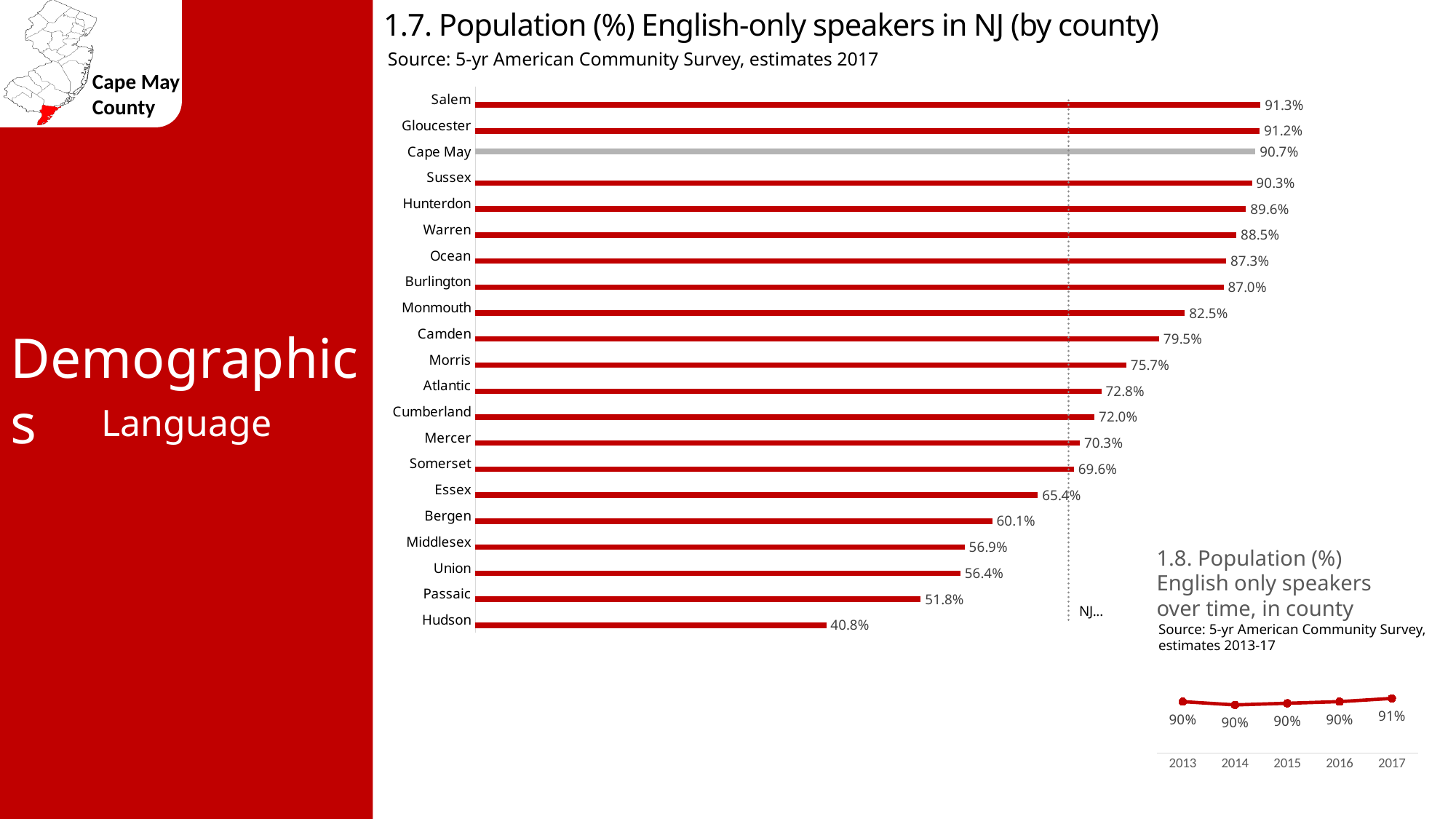
In chart 1.8, what is the value for 2017? 91% In chart 1.7, what is the value for Monmouth? 82.5% In chart 1.7, which county has the lowest percentage of English-only speakers? Hudson In chart 1.7, how many counties are shown? 21 In chart 1.7, which bar is shown in grey rather than red? Cape May In chart 1.7, what is the value for Cape May? 90.7% In chart 1.7, what is the value for Hudson? 40.8% In chart 1.8, how many years are plotted? 5 In chart 1.7, which is larger, the value for Bergen or the value for Essex? Essex In chart 1.7, which county has the highest percentage of English-only speakers? Salem In chart 1.7, what is the difference between the values for Salem and Hudson? 50.5% What kind of chart is chart 1.7? Bar chart